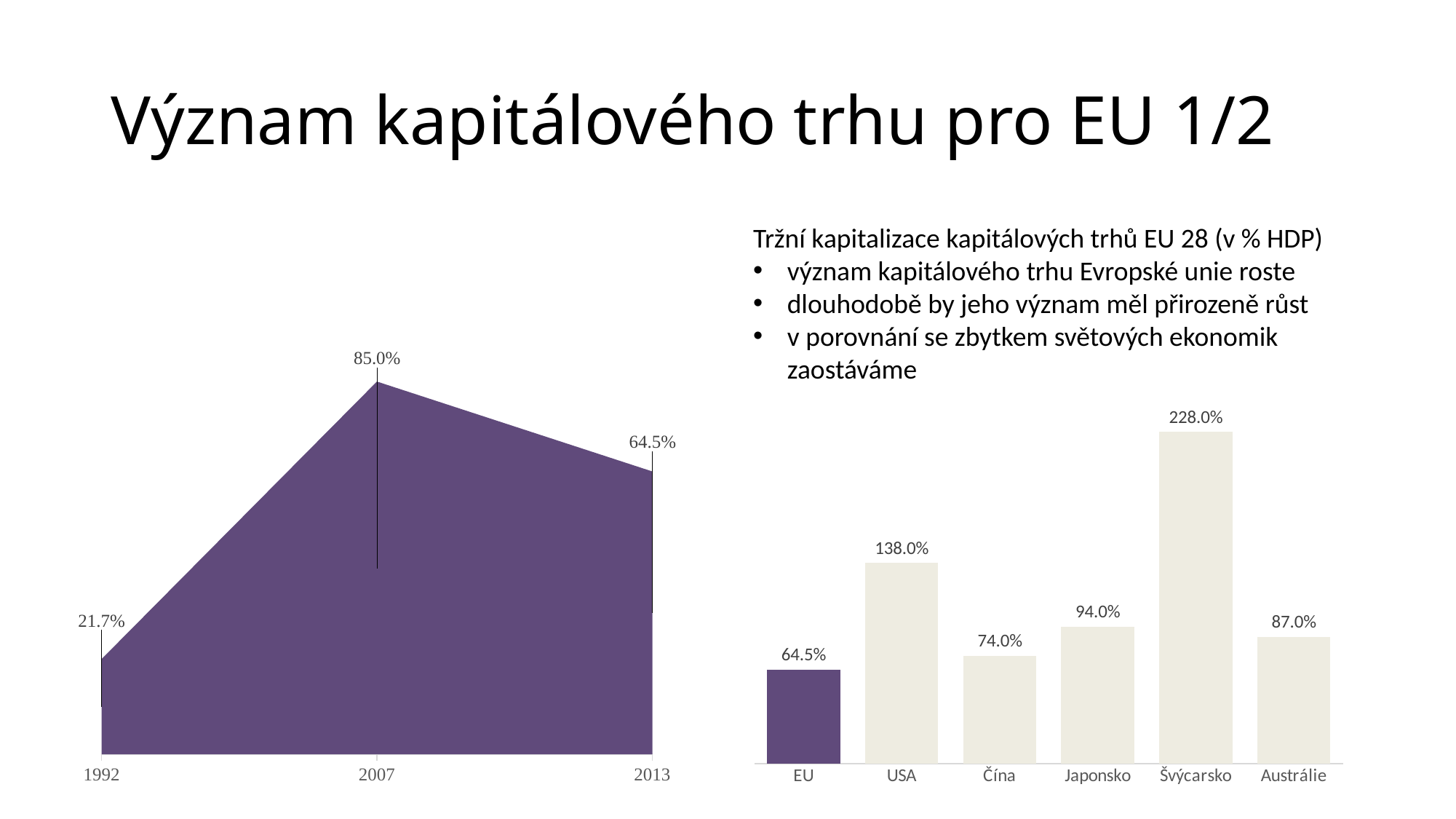
In the left chart, which year has the highest value? 2007 In the left chart, what kind of chart is shown? area chart In the left chart, does the value rise or fall from 2007 to 2013? fall In the right chart, what is the value for Japonsko? 94.0% In the right chart, which category has the lowest value? EU In the right chart, what is the difference between the USA and Čína values? 64.0% In the right chart, which is larger, USA or Austrálie? USA In the right chart, how many categories are shown? 6 In the left chart, what is the value for 1992? 21.7% In the left chart, what is the value for 2007? 85.0% In the left chart, what is the difference between the 2007 and 2013 values? 20.5% In the right chart, what is the value for Švýcarsko? 228.0%